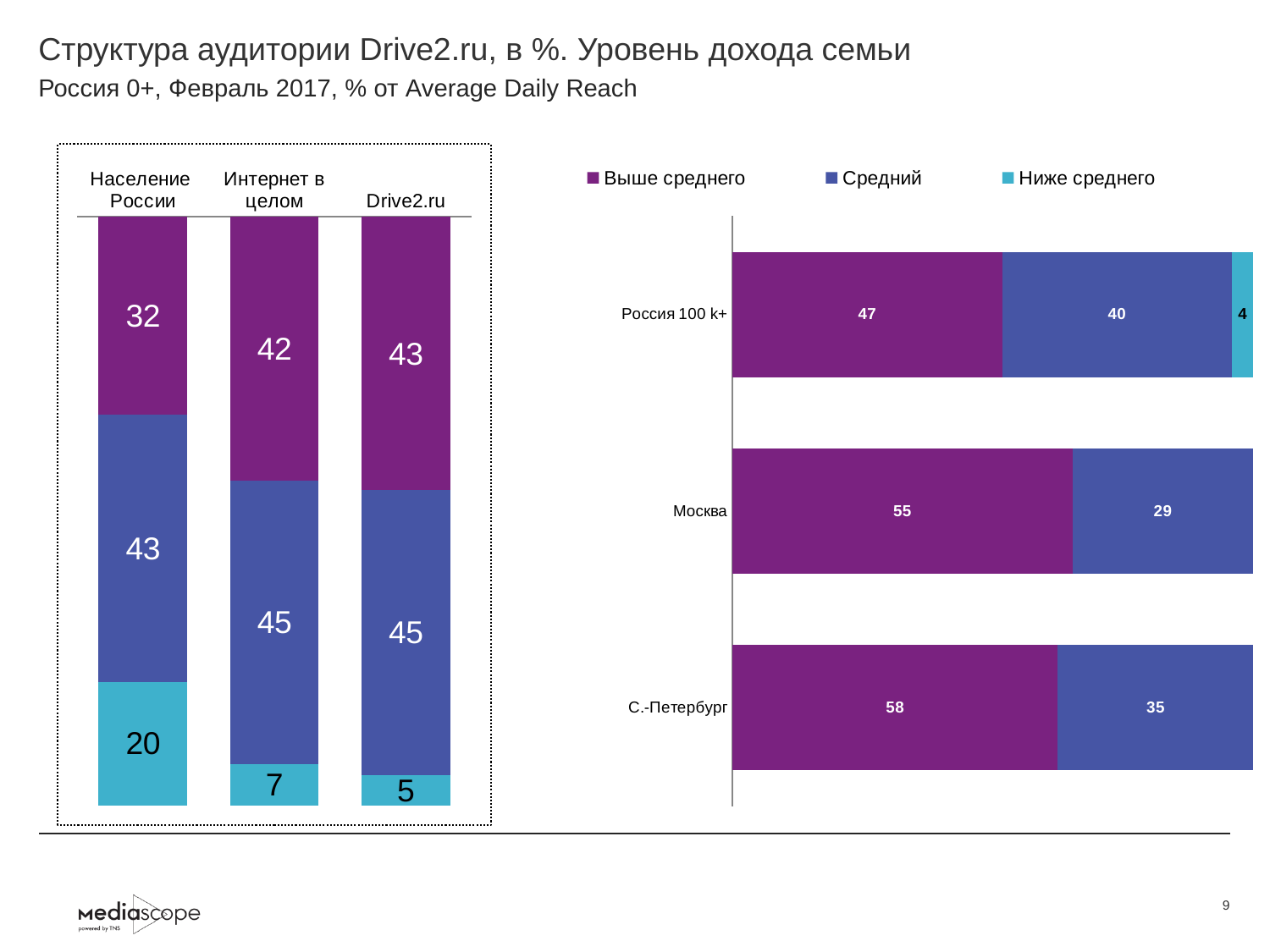
In the left chart, what is the value of the 'Выше среднего' segment for Drive2.ru? 43 In the right chart, is the 'Выше среднего' value larger for Россия 100 k+ or for Москва? Москва In the right chart, which category has the highest 'Выше среднего' value? С.-Петербург In the right chart, what is the 'Выше среднего' value for С.-Петербург? 58 What type of chart is the left chart? Stacked bar chart How many categories are shown in the right chart? 3 How many series does the legend of the right chart list? 3 In the left chart, what is the value of the 'Ниже среднего' segment for Население России? 20 In the left chart, what is the difference between the 'Средний' values for Drive2.ru and Население России? 2 In the right chart, what is the 'Средний' value for Москва? 29 In the left chart, what is the total of the printed values for the Интернет в целом bar? 94 In the left chart, which category has the lowest 'Ниже среднего' value? Drive2.ru